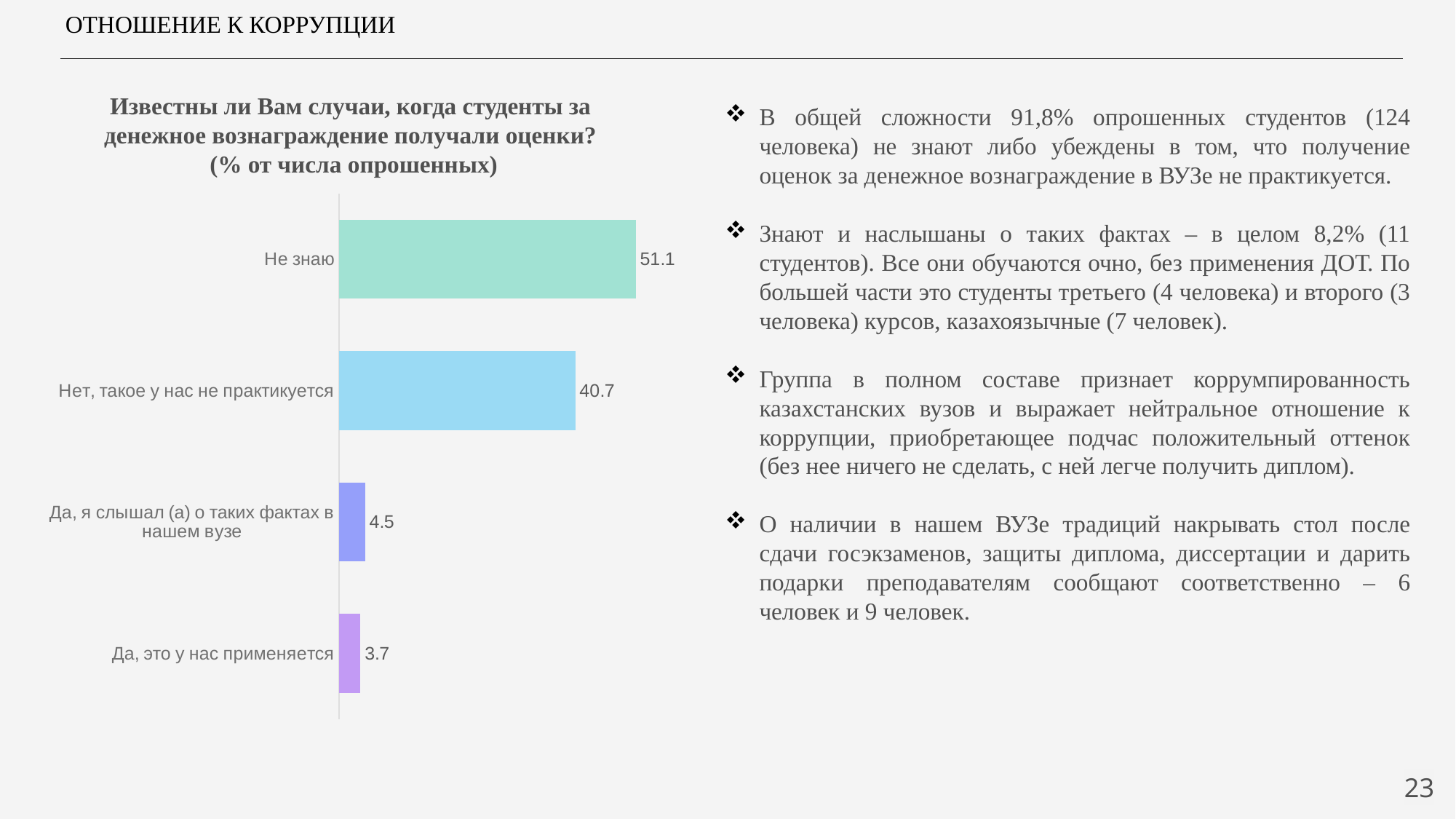
What is the value for "Не знаю"? 51.1 What is the title of the chart? Известны ли Вам случаи, когда студенты за денежное вознаграждение получали оценки? (% от числа опрошенных) What is the value for "Нет, такое у нас не практикуется"? 40.7 What kind of chart is shown on the slide? Bar chart Which category has the lowest value? Да, это у нас применяется Which category has the highest value? Не знаю Which is larger: the value for "Нет, такое у нас не практикуется" or the value for "Да, я слышал (а) о таких фактах в нашем вузе"? Нет, такое у нас не практикуется What is the value for "Да, я слышал (а) о таких фактах в нашем вузе"? 4.5 What is the difference between the values for "Да, я слышал (а) о таких фактах в нашем вузе" and "Да, это у нас применяется"? 0.8 What is the difference between the values for "Не знаю" and "Нет, такое у нас не практикуется"? 10.4 How many categories are shown in the chart? 4 What is the value for "Да, это у нас применяется"? 3.7